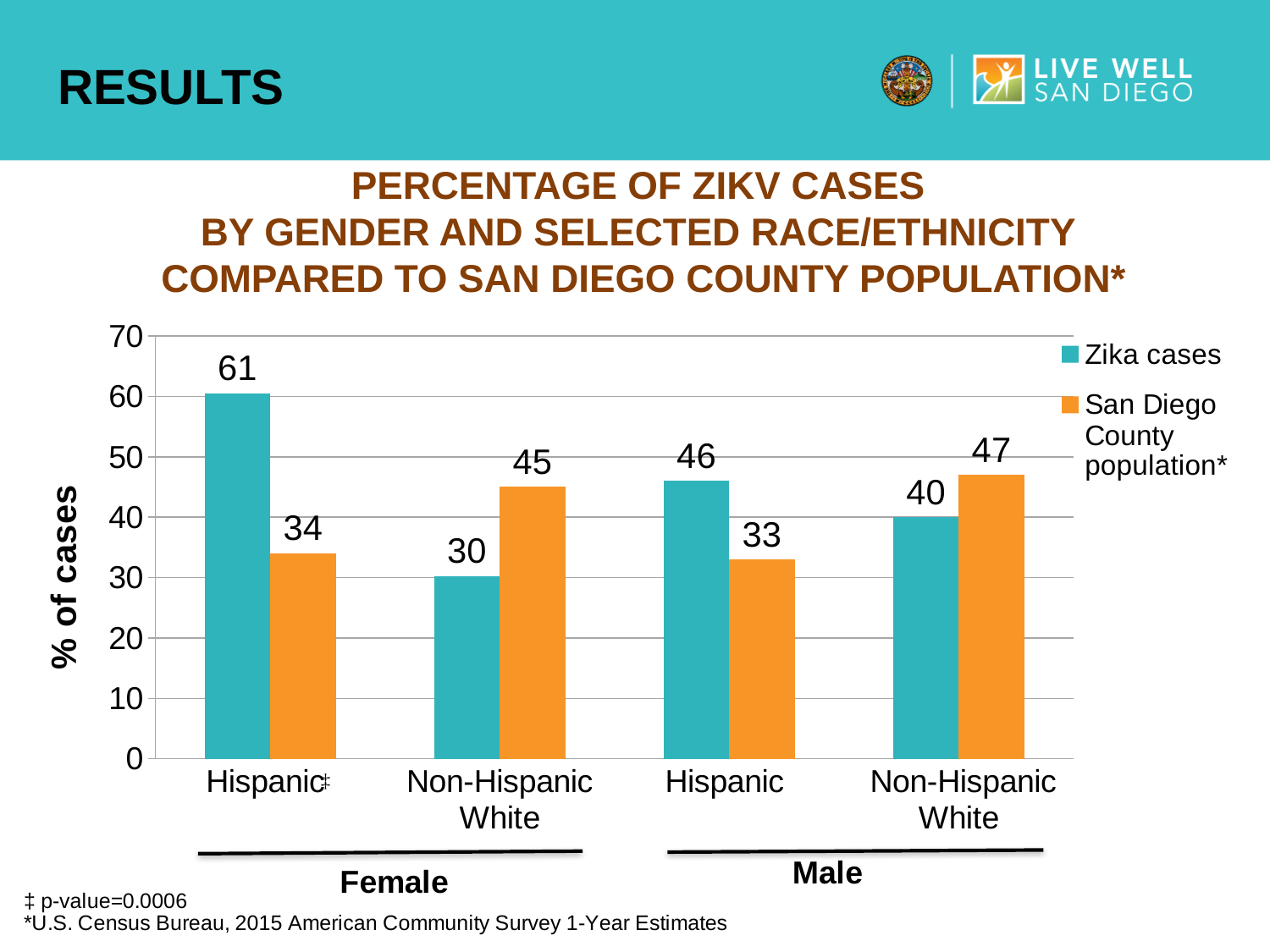
What is the San Diego County population value for Male Hispanic? 33 How many series does the legend list? 2 For Male Hispanic, which is larger: Zika cases or San Diego County population? Zika cases What is the difference between the Zika cases value and the San Diego County population value for Female Hispanic? 27 What is the label of the y axis? % of cases What is the Zika cases value for Female Non-Hispanic White? 30 Which category has the lowest Zika cases value? Female Non-Hispanic White What kind of chart is shown on the slide? Bar chart Which category has the highest Zika cases value? Female Hispanic What is the San Diego County population value for Male Non-Hispanic White? 47 What percentage of Zika cases are Female Hispanic? 61 How many categories are shown on the x axis? 4